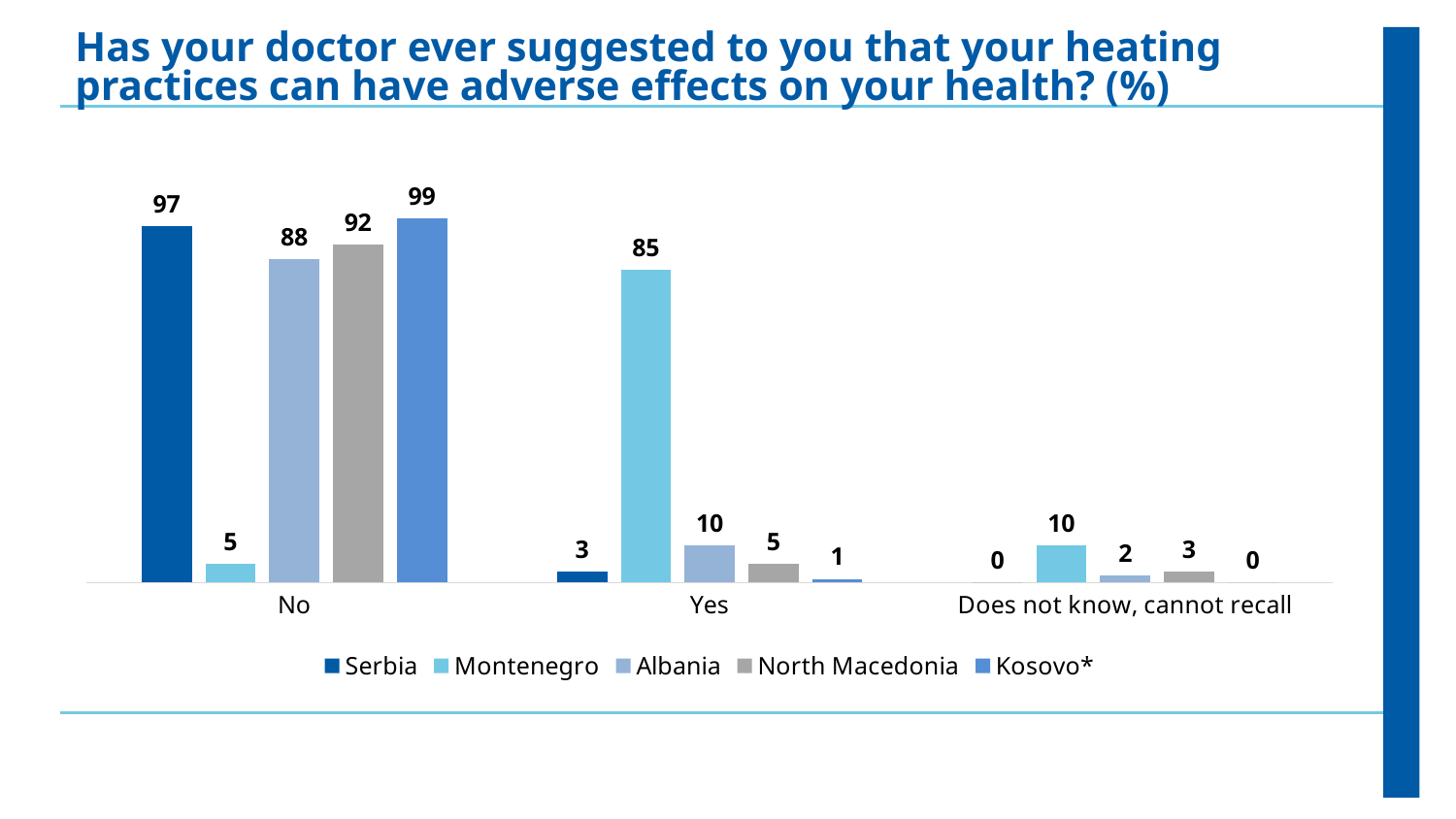
Which country has the lowest value in the "No" category? Montenegro What is the difference between Kosovo* and Albania in the "No" category? 11 How many countries does the legend list? 5 What is the value for Albania in the "Does not know, cannot recall" category? 2 What is the value for Serbia in the "No" category? 97 What is the value for Montenegro in the "Yes" category? 85 How many response categories are shown on the x axis? 3 Which country's bars are shown in light blue in the legend? Montenegro What kind of chart is shown on the slide? Bar chart Which is larger in the "Yes" category: Albania or North Macedonia? Albania What is the difference between Montenegro's "Yes" value and its "No" value? 80 Which country has the highest value in the "No" category? Kosovo*